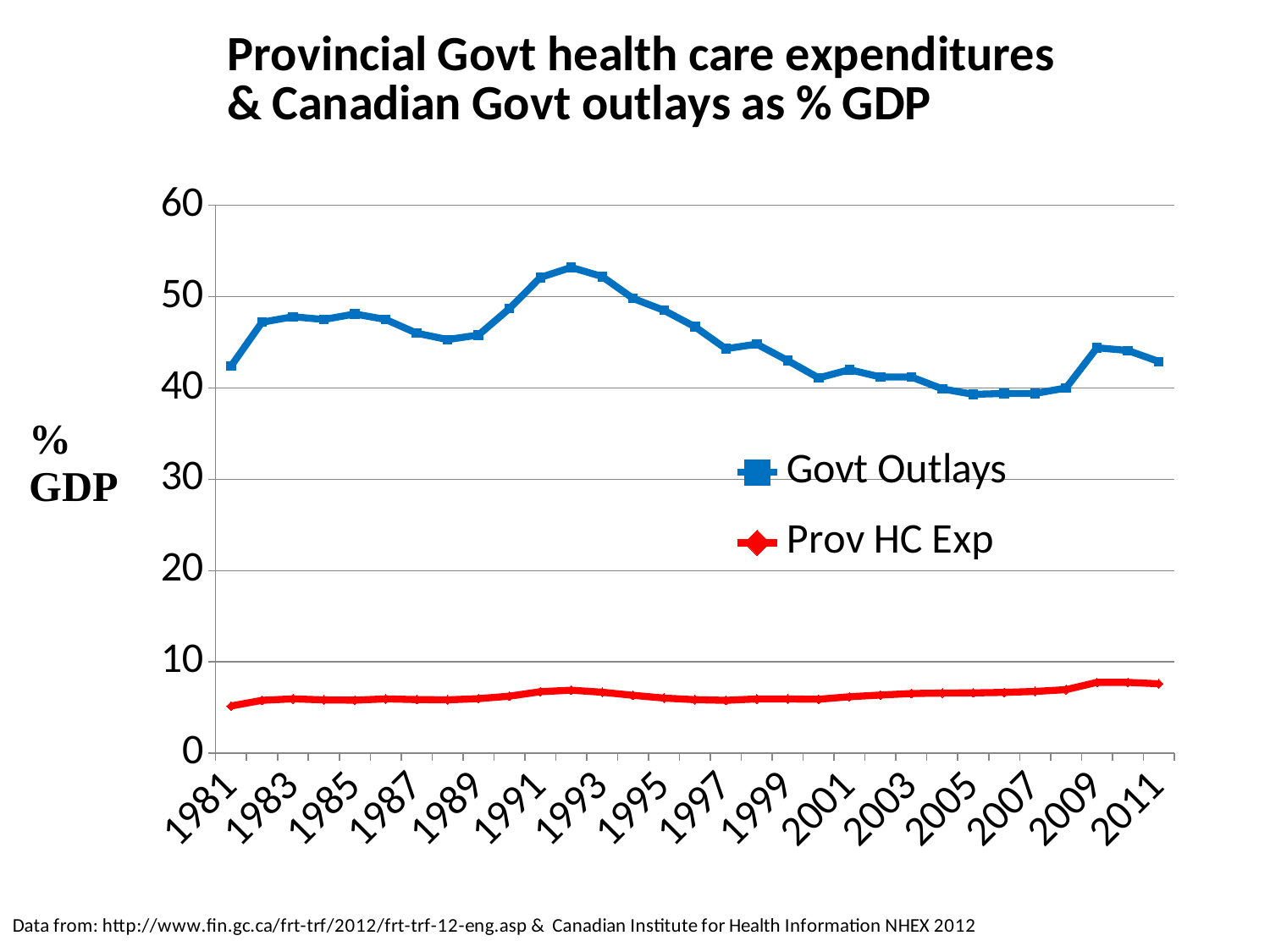
Which is larger for Govt Outlays, the value in 1992 or the value in 2007? 1992 What are the two series named in the legend? Govt Outlays and Prov HC Exp How many series does the legend list? 2 In which year is the Prov HC Exp series at its lowest value? 1981 In which year does the Govt Outlays series reach its highest value? 1992 What is the title of the chart? Provincial Govt health care expenditures & Canadian Govt outlays as % GDP Does the Govt Outlays series rise or fall between 1992 and 2007? Fall Is the value for Govt Outlays in 1981 greater or less than 40? greater What kind of chart is shown on the slide? Line chart Which series has the larger value in 2001, Govt Outlays or Prov HC Exp? Govt Outlays Is the value for Prov HC Exp in 2011 greater or less than 10? less Is the value for Govt Outlays in 1992 greater or less than 50? greater